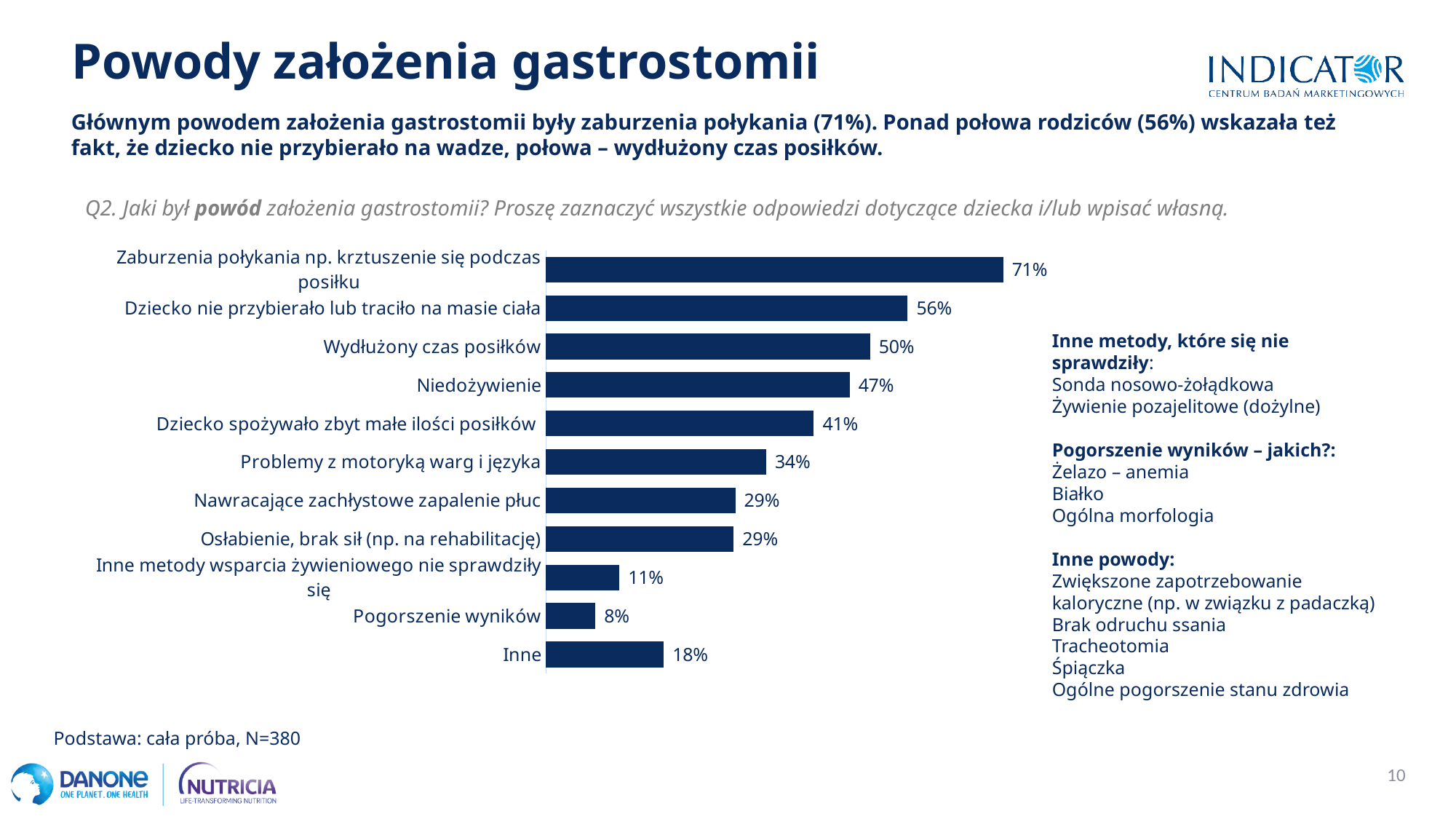
What is the value for "Problemy z motoryką warg i języka"? 34% How many categories are shown in the chart? 11 Which category has the highest value? Zaburzenia połykania np. krztuszenie się podczas posiłku What is the value for "Inne metody wsparcia żywieniowego nie sprawdziły się"? 11% What is the difference between the values for "Zaburzenia połykania np. krztuszenie się podczas posiłku" and "Inne"? 53% What is the difference between the values for "Dziecko nie przybierało lub traciło na masie ciała" and "Wydłużony czas posiłków"? 6% Which category has the lowest value? Pogorszenie wyników What is the value for "Niedożywienie"? 47% Which is larger: the value for "Dziecko spożywało zbyt małe ilości posiłków" or the value for "Nawracające zachłystowe zapalenie płuc"? Dziecko spożywało zbyt małe ilości posiłków What kind of chart is shown on the slide? Bar chart What is the sample size stated below the chart? N=380 What is the value for "Inne"? 18%